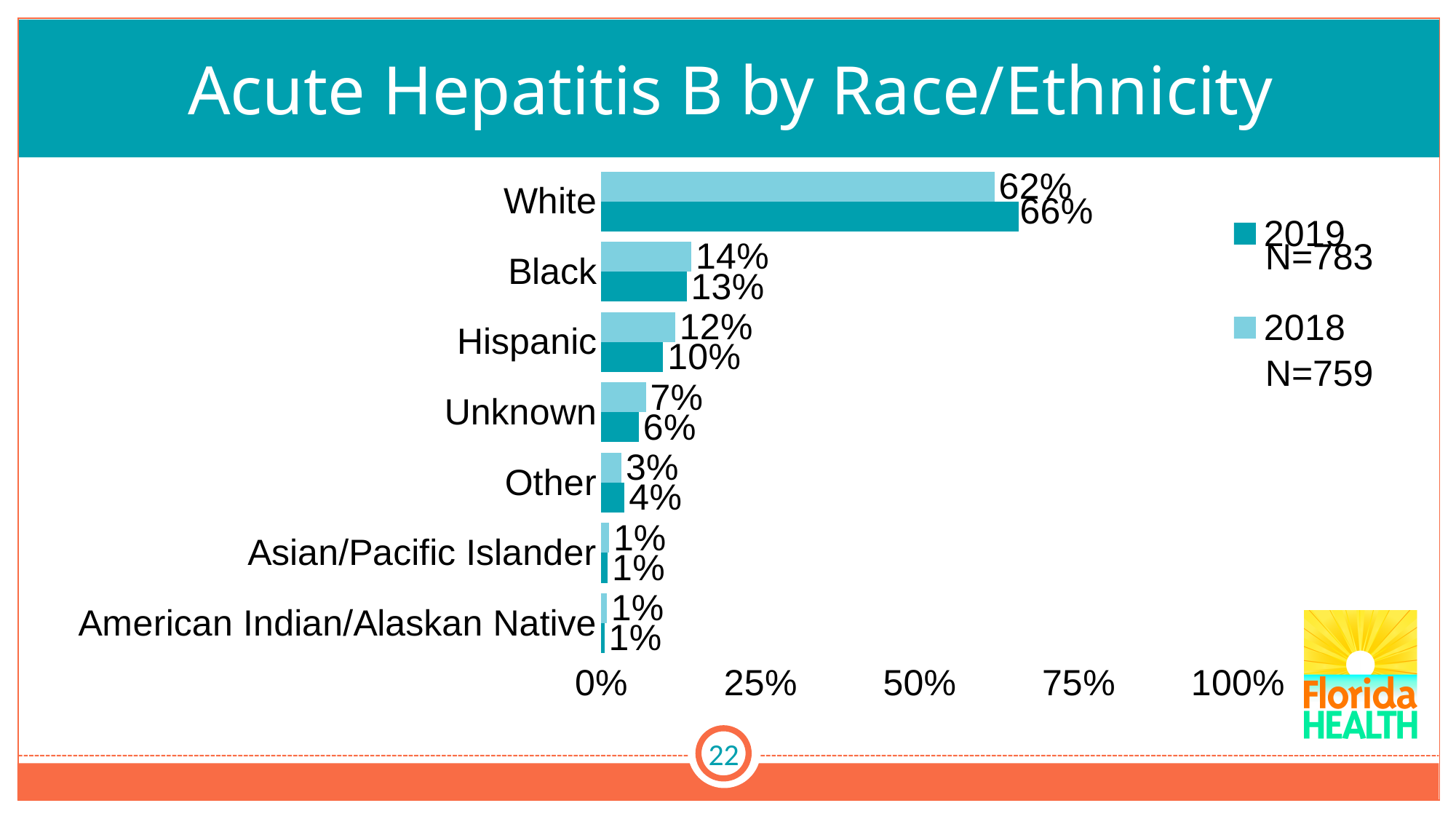
What is the 2018 value for Black? 14% Is the 2018 value for White greater or less than 50%? greater How many series does the legend list? 2 What is the 2018 value for Unknown? 7% What is the difference between the 2019 and 2018 values for White? 4% What is the 2019 value for Hispanic? 10% Which is larger for Other: the 2018 value or the 2019 value? 2019 How many race/ethnicity categories are shown on the chart? 7 What kind of chart is shown on the slide? Bar chart Which race/ethnicity category has the highest 2019 value? White What is the 2019 value for White? 66% What is the N for 2019 shown in the legend? N=783